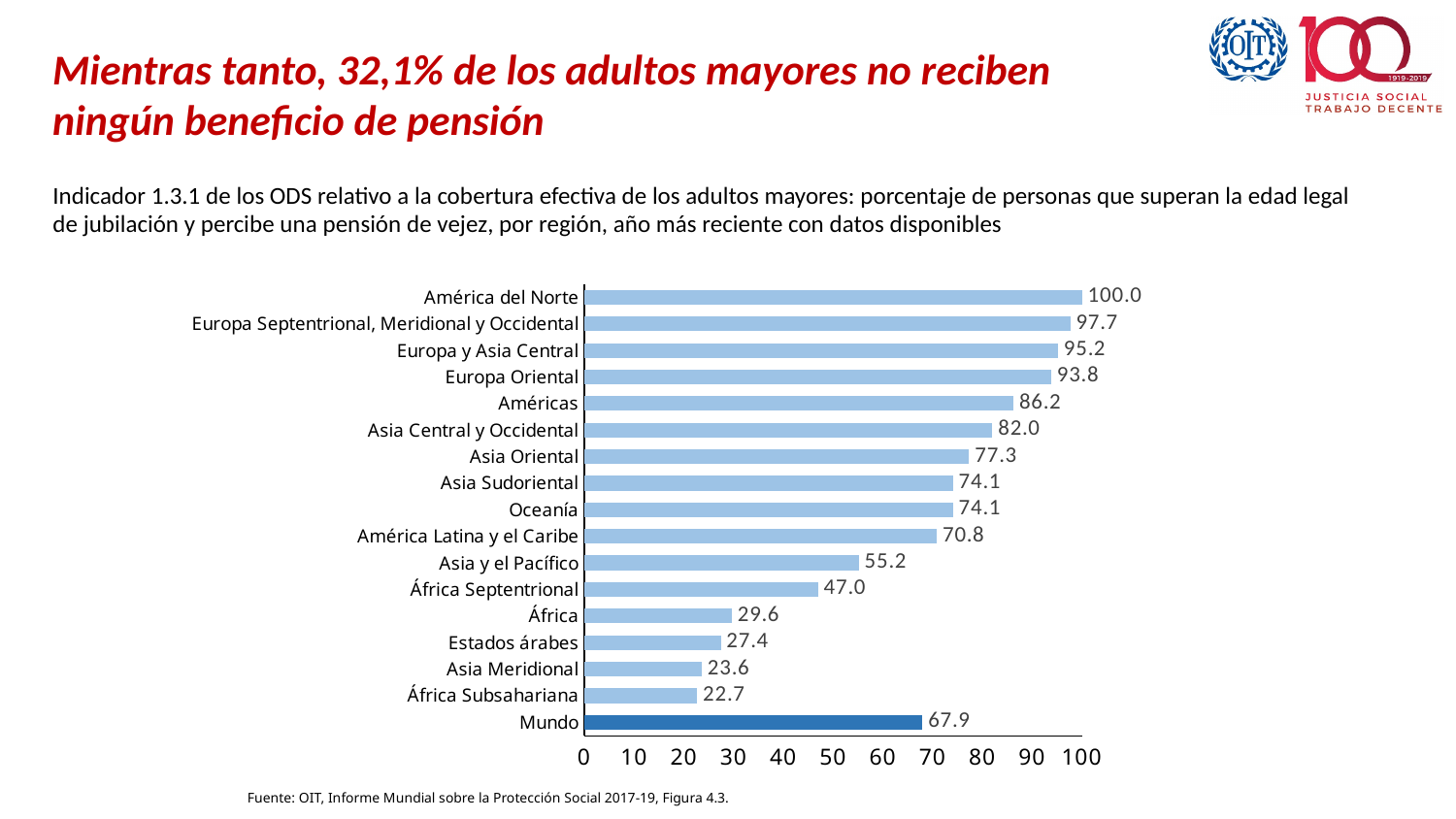
Which region has the highest value? América del Norte Which is larger, the value for África Septentrional or the value for Estados árabes? África Septentrional Is the value for América Latina y el Caribe greater or less than 60? greater What is the value for África Subsahariana? 22.7 Which region has the lowest value? África Subsahariana What is the value for Mundo? 67.9 How many categories (bars) are shown in the chart? 17 Which bar is shown in a darker blue than the others? Mundo What is the value for Asia Central y Occidental? 82.0 What kind of chart is shown on the slide? bar chart What is the difference between the values for Europa Oriental and Asia Oriental? 16.5 What is the difference between the values for Mundo and Asia y el Pacífico? 12.7